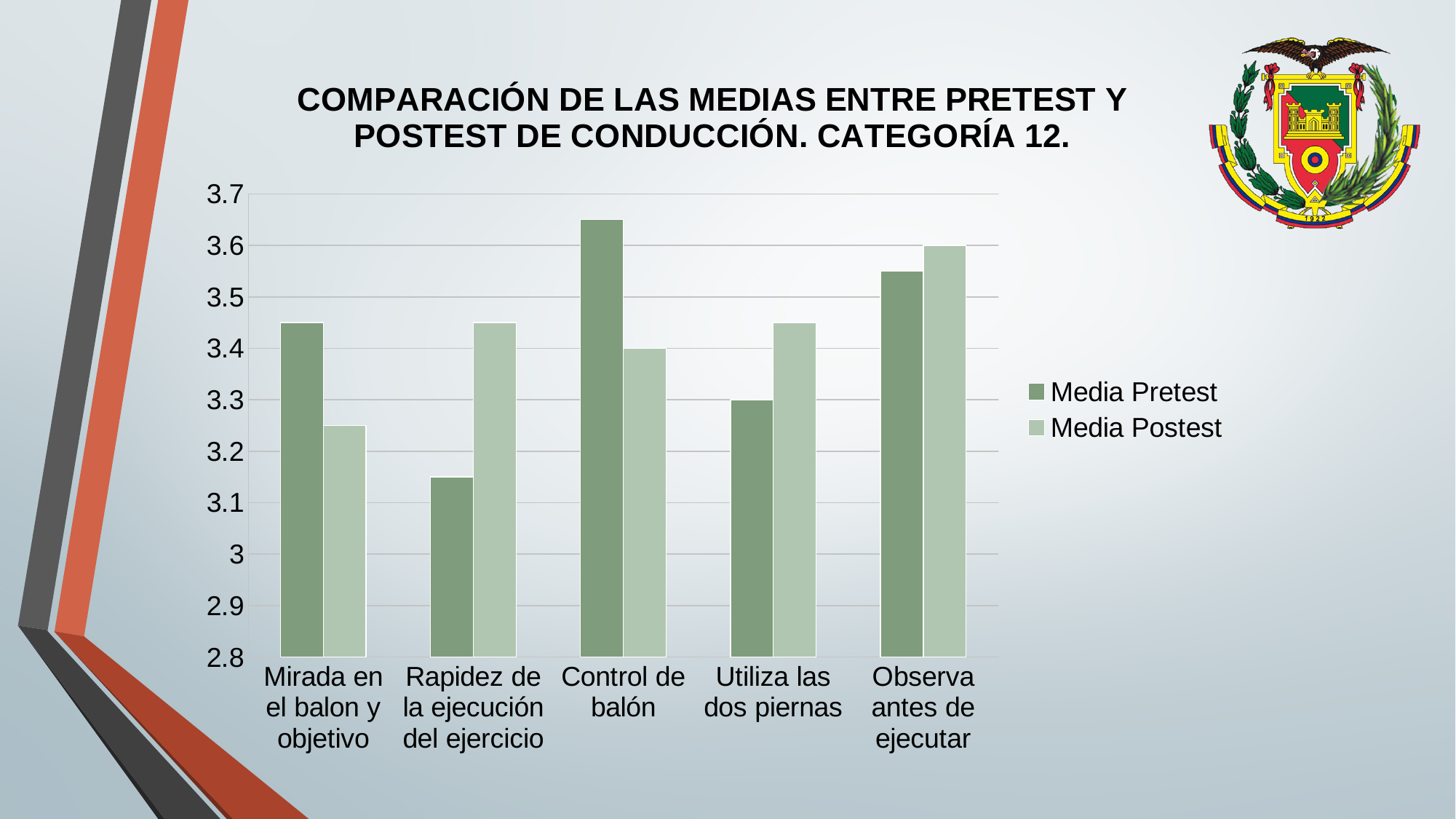
Is the Media Postest value for 'Utiliza las dos piernas' greater or less than 3.4? greater What kind of chart is shown on the slide? bar chart How many categories are shown on the x axis? 5 Is the Media Pretest value for 'Rapidez de la ejecución del ejercicio' greater or less than 3.2? less Which category has the lowest Media Pretest value? Rapidez de la ejecución del ejercicio What are the two series named in the legend? Media Pretest and Media Postest How many series does the legend list? 2 For 'Mirada en el balon y objetivo', which is larger: Media Pretest or Media Postest? Media Pretest Which category has the highest Media Postest value? Observa antes de ejecutar Is the Media Pretest value for 'Control de balón' greater or less than 3.6? greater Which category has the highest Media Pretest value? Control de balón Which category has the lowest Media Postest value? Mirada en el balon y objetivo